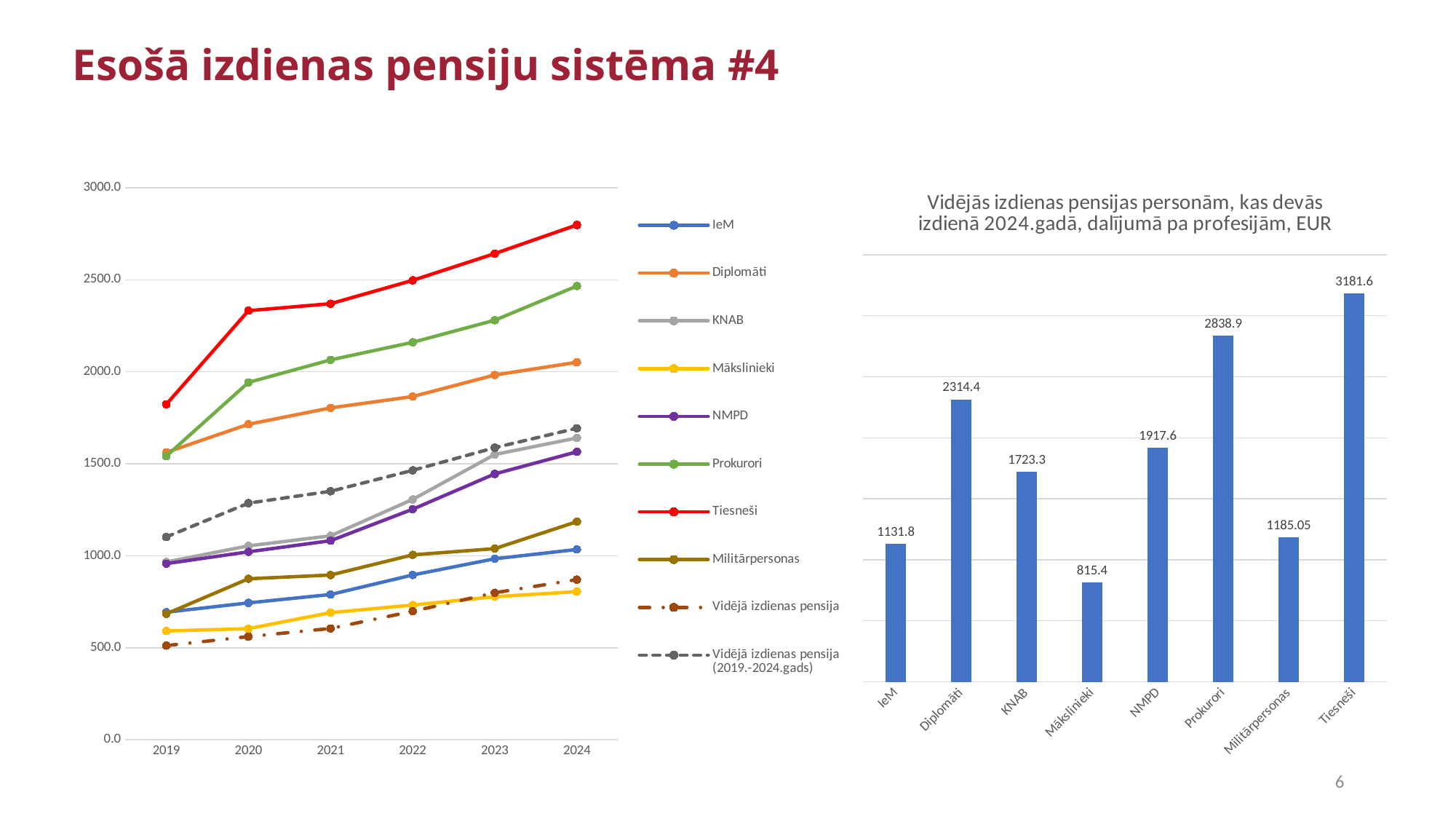
In the bar chart on the right, which profession has the highest value? Tiesneši In the bar chart on the right, what is the value for Militārpersonas? 1185.05 In the bar chart on the right, which is larger, the value for Diplomāti or the value for NMPD? Diplomāti How many series does the legend of the line chart on the left list? 10 What type of chart is the chart on the right? bar chart What is the title of the bar chart on the right? Vidējās izdienas pensijas personām, kas devās izdienā 2024.gadā, dalījumā pa profesijām, EUR In the line chart on the left, does the Prokurori series rise or fall from 2019 to 2024? rise In the line chart on the left, is the value for Tiesneši in 2024 greater or less than 2500? greater How many professions are shown in the bar chart on the right? 8 In the bar chart on the right, what is the value for Prokurori? 2838.9 In the bar chart on the right, which profession has the lowest value? Mākslinieki In the bar chart on the right, what is the difference between the values for Tiesneši and Prokurori? 342.7